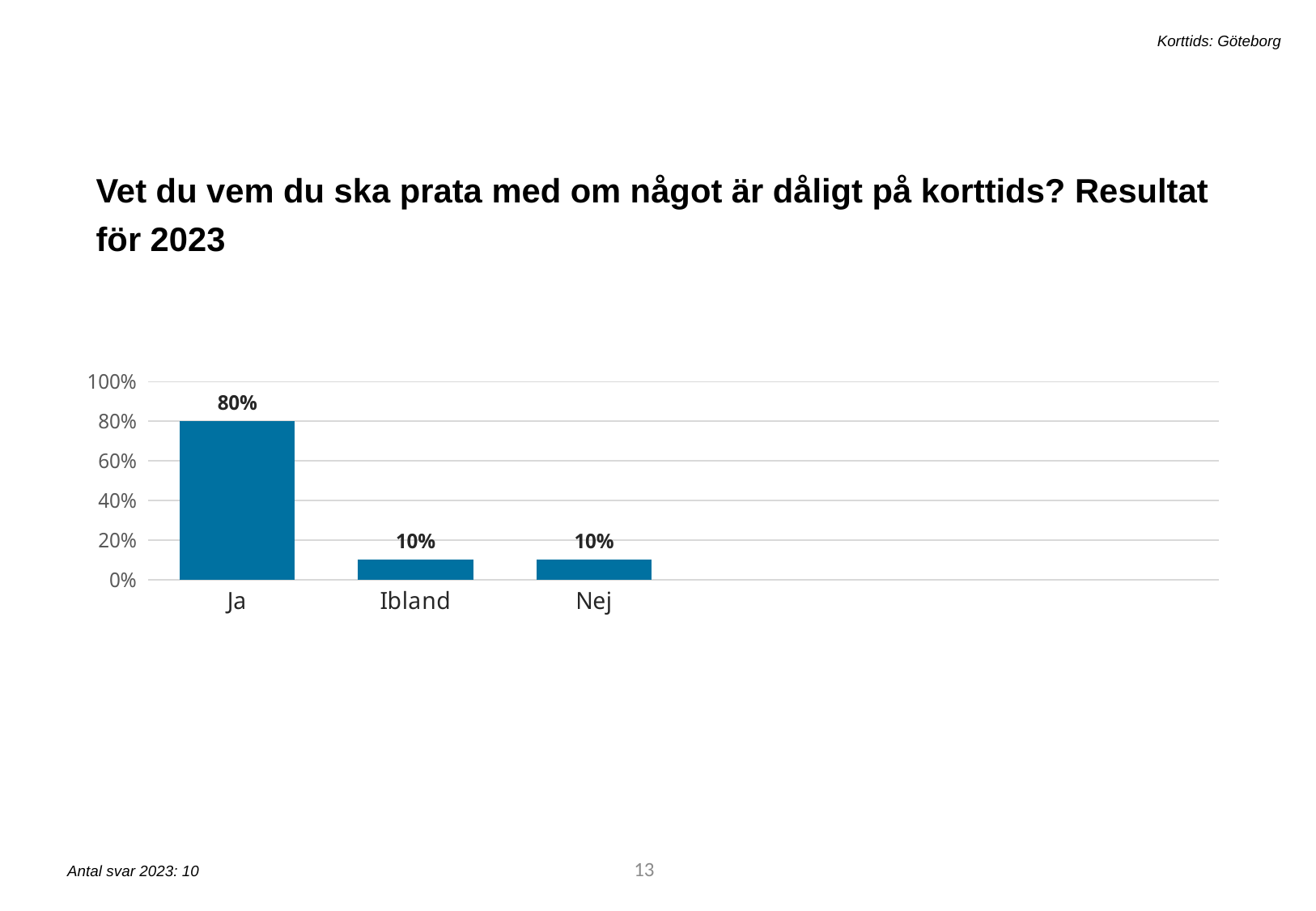
What is the value for Nej? 10% How many categories are shown on the x axis? 3 What is the difference between the values for Ja and Nej? 70% Which is larger, the value for Ja or the value for Ibland? Ja Which category has the highest value? Ja What is the highest value shown on the y axis? 100% Is the value for Nej greater or less than 20%? less What kind of chart is shown on the slide? bar chart What is the value for Ibland? 10% What is the difference between the values for Ja and Ibland? 70% What is the value for Ja? 80% Is the value for Ja greater or less than 60%? greater